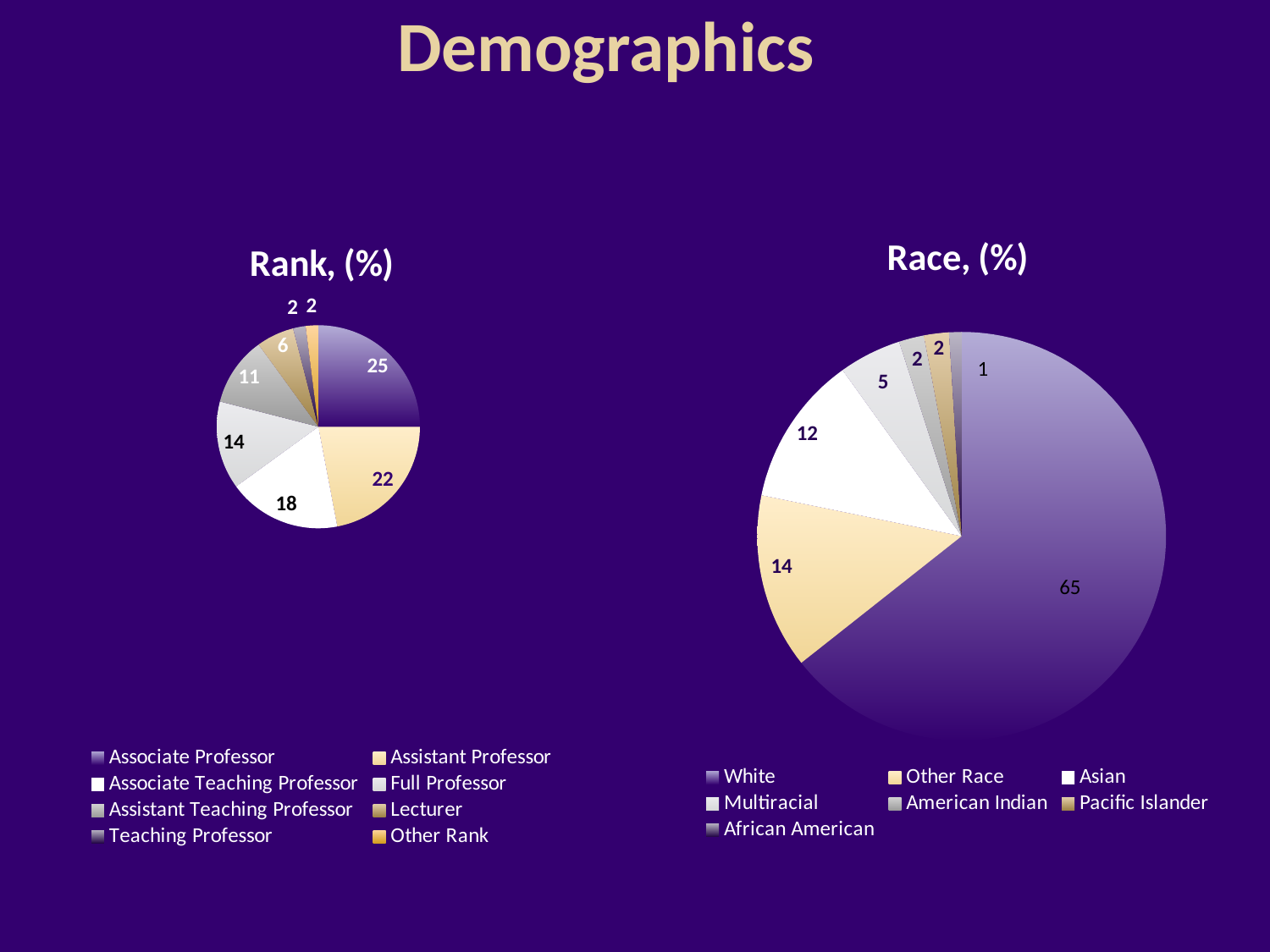
On the Rank, (%) chart, what is the value for Associate Professor? 25 On the Race, (%) chart, what is the value for Other Race? 14 On the Rank, (%) chart, which category has the largest slice? Associate Professor On the Race, (%) chart, what is the value for White? 65 On the Rank, (%) chart, what is the value for Full Professor? 14 On the Rank, (%) chart, how many categories does the legend list? 8 On the Rank, (%) chart, what is the value for Assistant Professor? 22 What kind of chart is the Race, (%) chart? Pie chart On the Rank, (%) chart, what is the difference between Associate Professor and Associate Teaching Professor? 7 On the Race, (%) chart, how many categories does the legend list? 7 On the Race, (%) chart, which is larger, Asian or Multiracial? Asian On the Race, (%) chart, which category has the smallest slice? African American